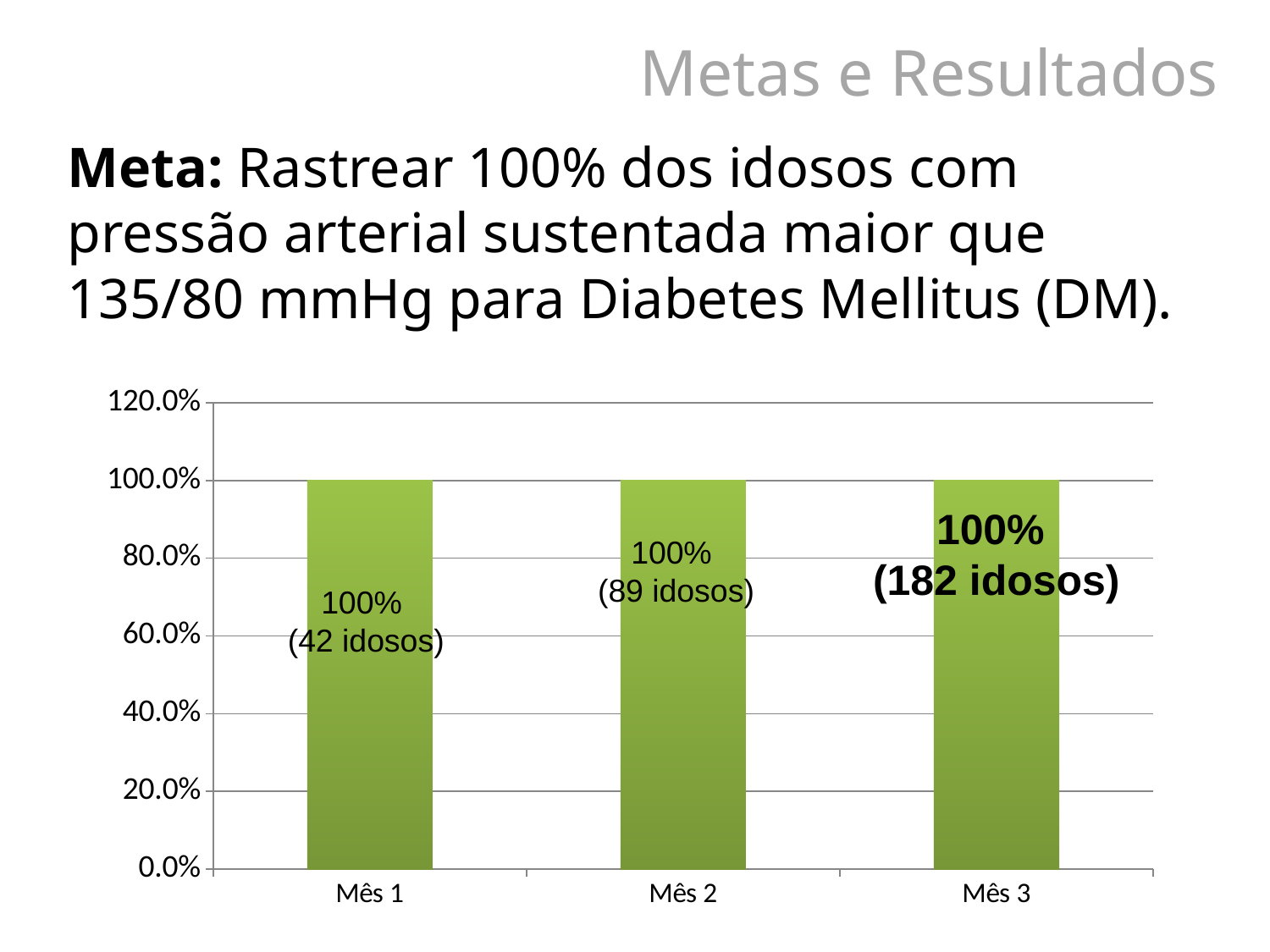
How many idosos are shown in the data label for Mês 1? 42 idosos What is the difference in the number of idosos between Mês 3 and Mês 1? 140 How many idosos are shown in the data label for Mês 3? 182 idosos What is the value for Mês 3? 100% What is the highest value shown on the y axis? 120.0% Is the value for Mês 2 greater or less than 80.0%? greater What kind of chart is shown on the slide? bar chart How many idosos are shown in the data label for Mês 2? 89 idosos What is the value for Mês 1? 100% Do the percentage values rise, fall or stay the same from Mês 1 to Mês 3? stay the same How many categories are shown on the x axis? 3 What colour are the bars in the chart? green